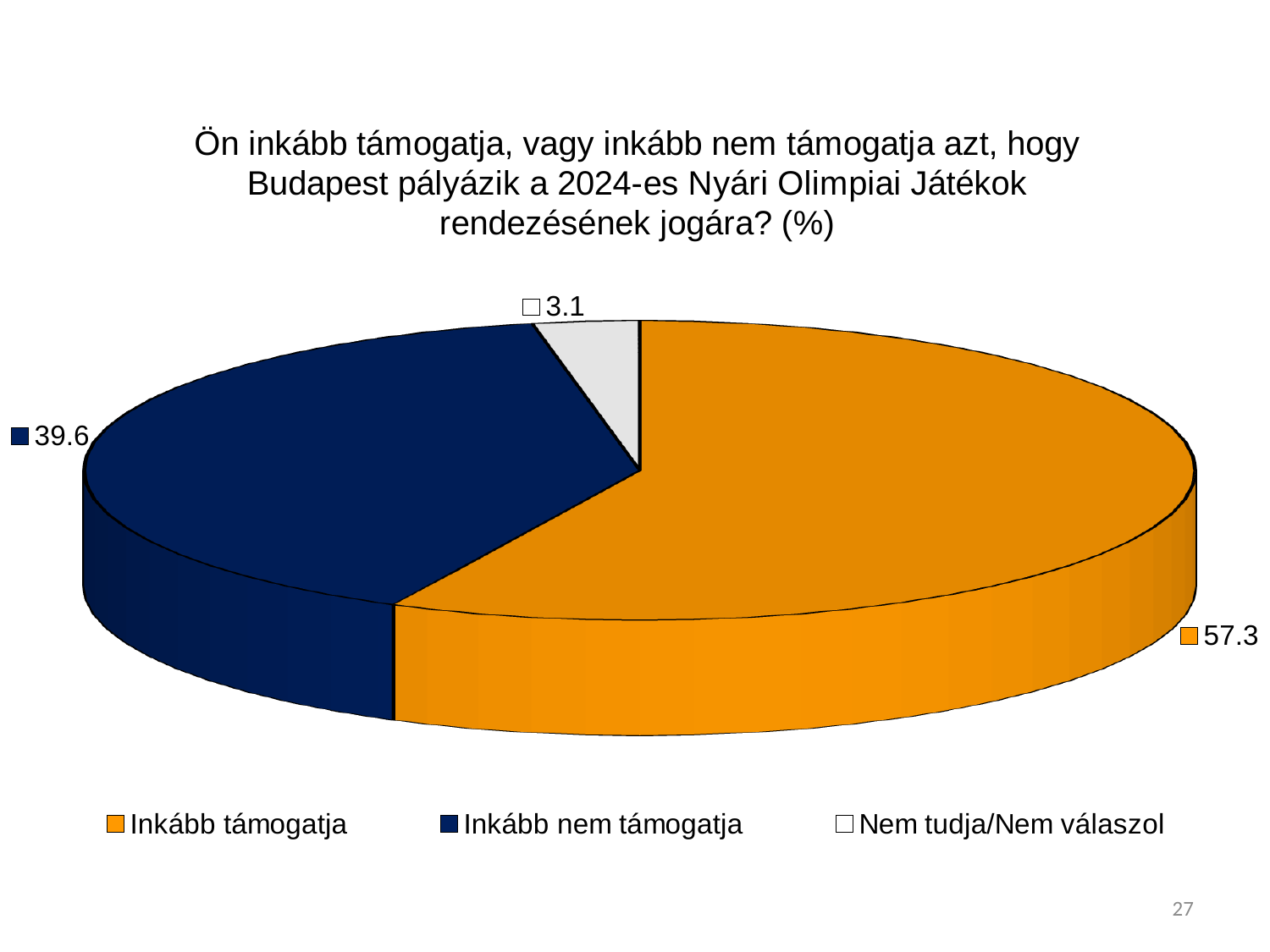
How many categories does the pie chart show? 3 What value is shown for "Inkább támogatja"? 57.3 What is the difference between the values for "Inkább támogatja" and "Inkább nem támogatja"? 17.7 What is the difference between the values for "Inkább nem támogatja" and "Nem tudja/Nem válaszol"? 36.5 What value is shown for "Nem tudja/Nem válaszol"? 3.1 Which is larger, the value for "Inkább nem támogatja" or the value for "Nem tudja/Nem válaszol"? Inkább nem támogatja What kind of chart is shown on the slide? Pie chart Which category has the largest slice of the pie? Inkább támogatja Which colour represents "Inkább nem támogatja" in the chart? Dark blue Which category has the smallest slice of the pie? Nem tudja/Nem válaszol How many entries does the legend list? 3 What value is shown for "Inkább nem támogatja"? 39.6